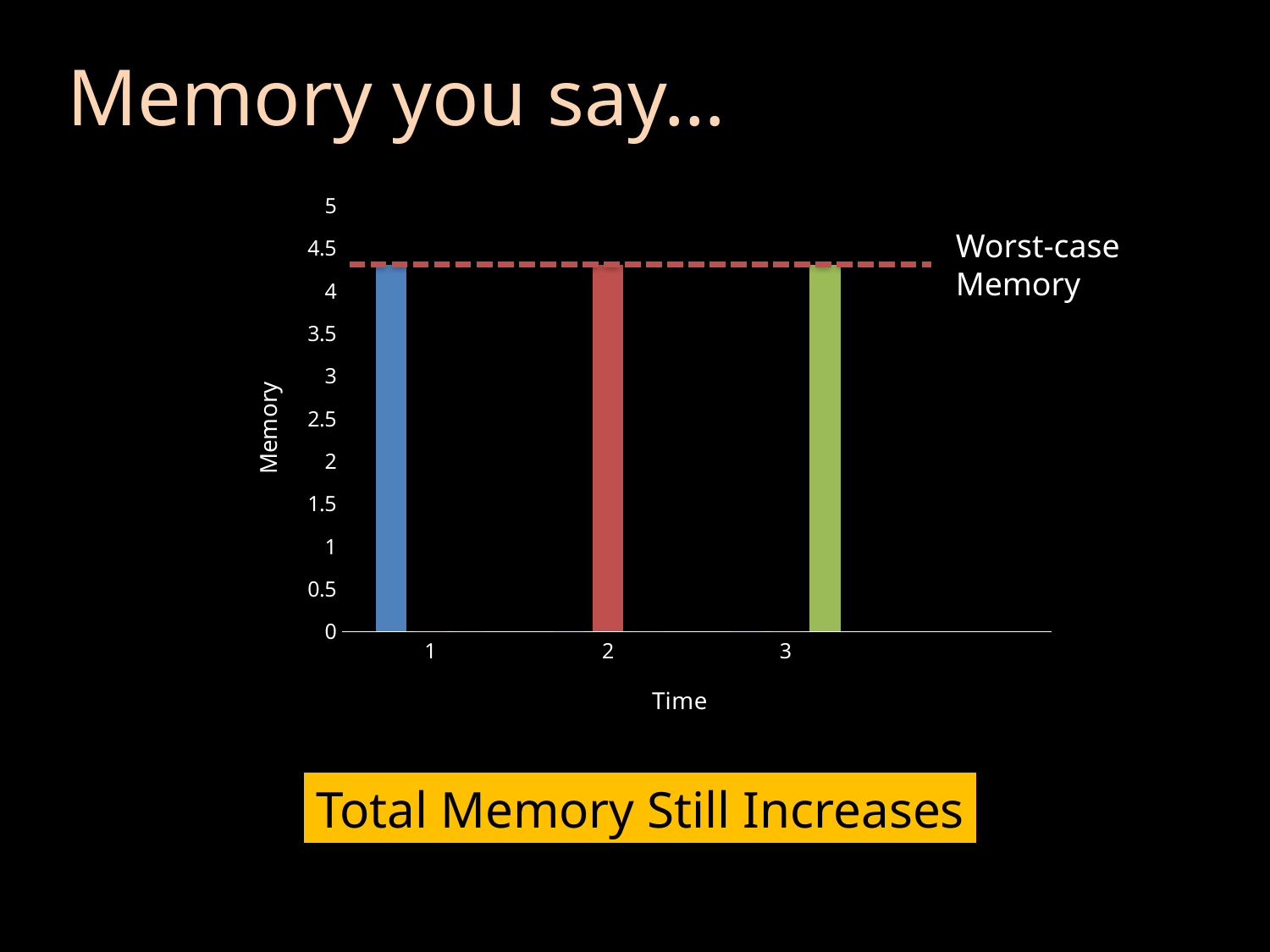
What does the dashed horizontal line in the chart represent? Worst-case Memory Is the value for Time 1 greater or less than 4? greater Do the bar values rise, fall, or stay about the same from Time 1 to Time 3? stay about the same Is the value for Time 3 greater or less than 3? greater What is the label of the y axis? Memory How many bars are plotted in the chart? 3 What kind of chart is shown on the slide? bar chart Is the value for Time 3 greater or less than 4.5? less